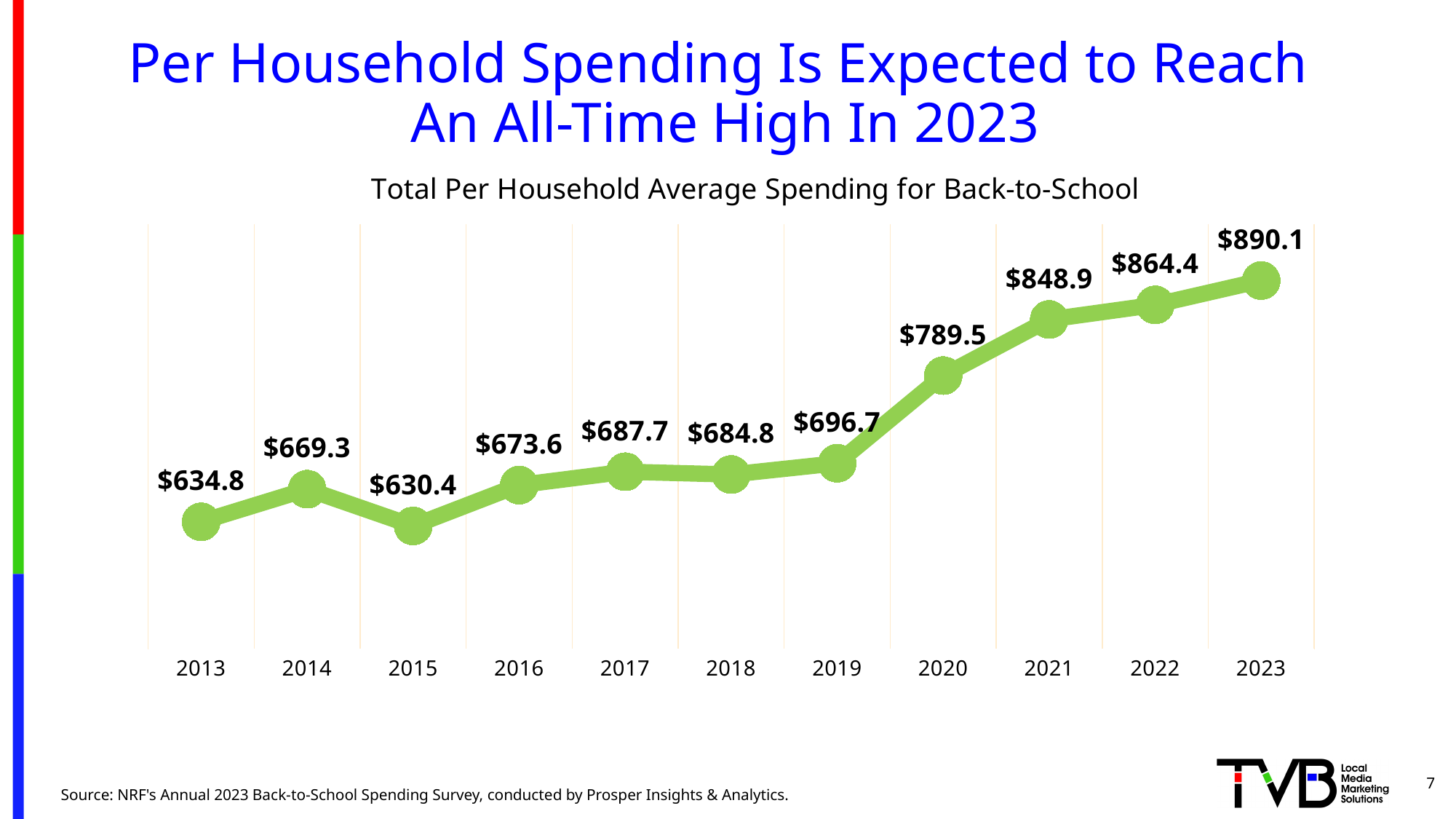
What kind of chart is shown on the slide? Line chart Which year has the highest per household average spending? 2023 Which year has the lowest per household average spending? 2015 Does per household spending generally rise or fall from 2015 to 2023? Rise What is the total per household average spending for back-to-school in 2023? $890.1 How much higher is the per household spending in 2023 than in 2022? $25.7 What is the difference in per household spending between 2020 and 2019? $92.8 What is the total per household average spending for back-to-school in 2015? $630.4 What is the total per household average spending for back-to-school in 2020? $789.5 How many years are plotted on the chart? 11 Which year has higher per household spending, 2017 or 2018? 2017 What is the title of the chart? Total Per Household Average Spending for Back-to-School